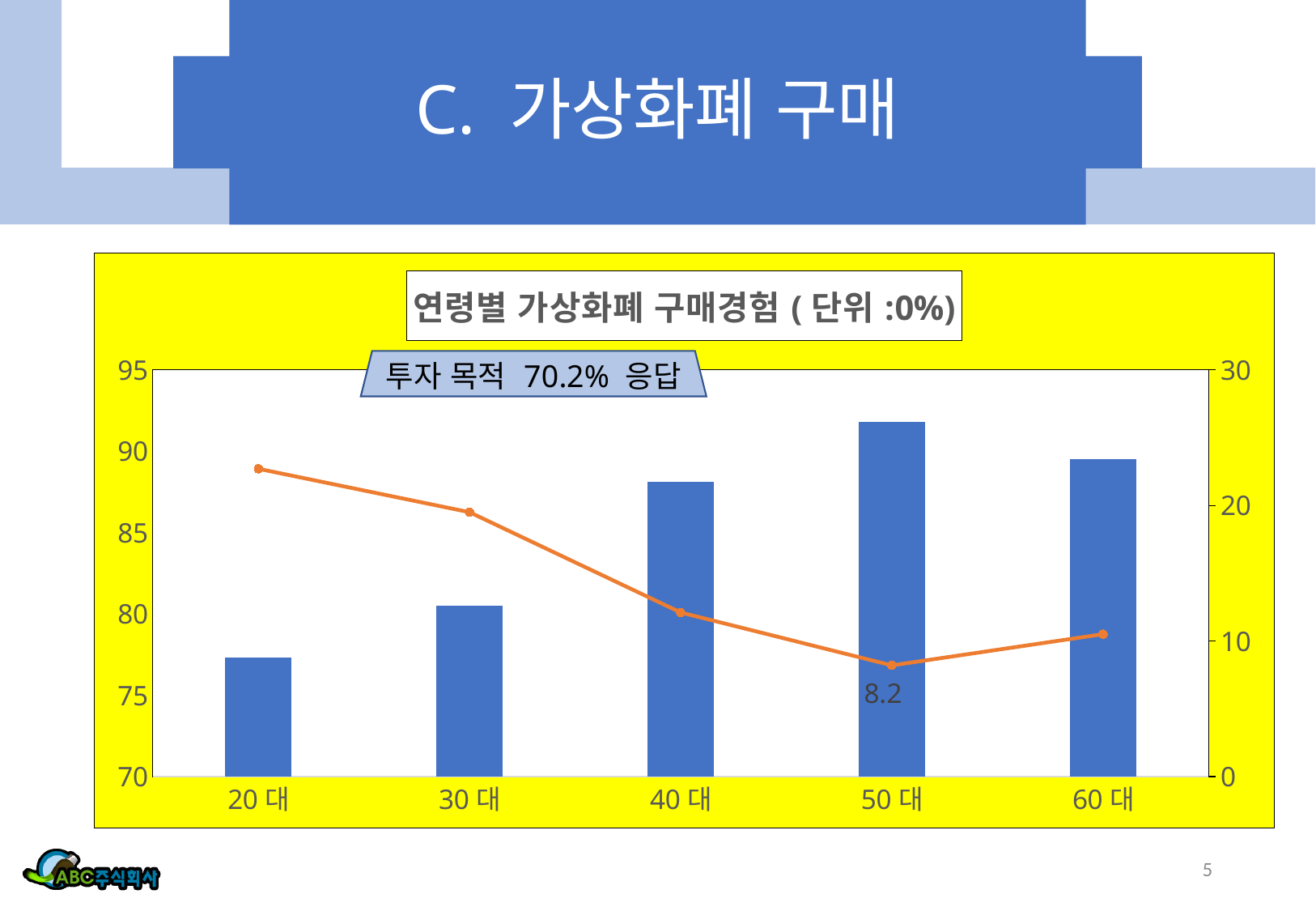
Does the line rise or fall from 20 대 to 50 대? It falls Is the bar value for 50 대 greater or less than 90? greater What percentage is given in the callout box about investment purpose (투자 목적)? 70.2% Which age group has the shortest bar? 20 대 Which age group has the tallest bar? 50 대 Is the bar value for 20 대 greater or less than 80? less At which age group is the line at its highest point? 20 대 How many age-group categories are shown on the x axis? 5 What kind of chart is shown on the slide? A combination bar and line chart What value is labelled on the line at 50 대? 8.2 Is the line value for 20 대 (right axis) greater or less than 20? greater Which has the taller bar, 30 대 or 40 대? 40 대